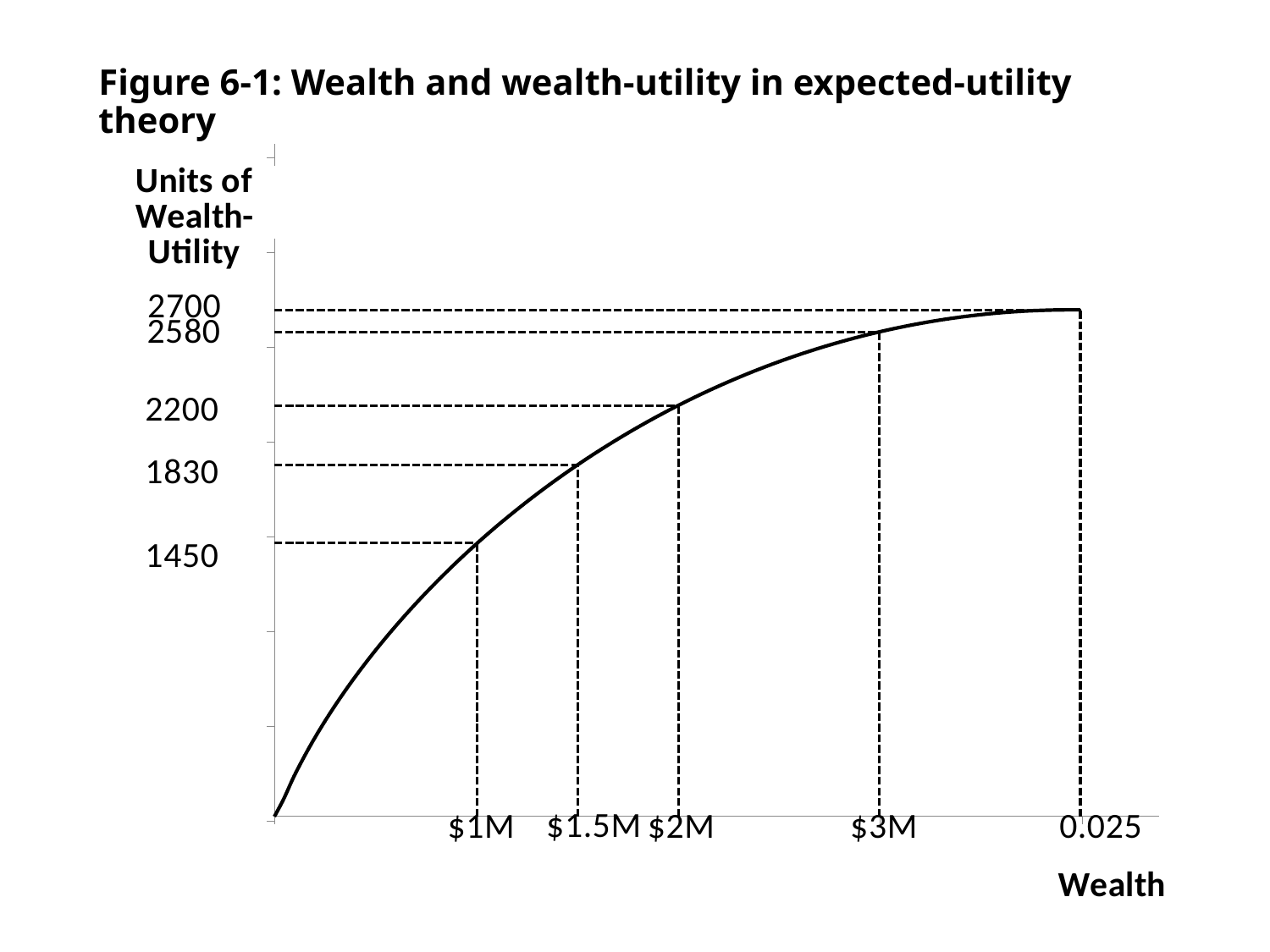
How many wealth points are marked with dashed lines on the x axis? 5 What is the difference in wealth-utility between $3M and $2M of wealth? 380 What is the highest wealth-utility value labelled on the y axis? 2700 What kind of chart is shown on the slide? line chart What is the wealth-utility value at a wealth of $3M? 2580 What is the title of the figure on the slide? Figure 6-1: Wealth and wealth-utility in expected-utility theory Does wealth-utility rise or fall as wealth increases along the x axis? rises What is the wealth-utility value at a wealth of $2M? 2200 What is the difference in wealth-utility between $2M and $1M of wealth? 750 Which wealth level has the higher wealth-utility, $1.5M or $3M? $3M What is the wealth-utility value at a wealth of $1.5M? 1830 What is the wealth-utility value at a wealth of $1M? 1450